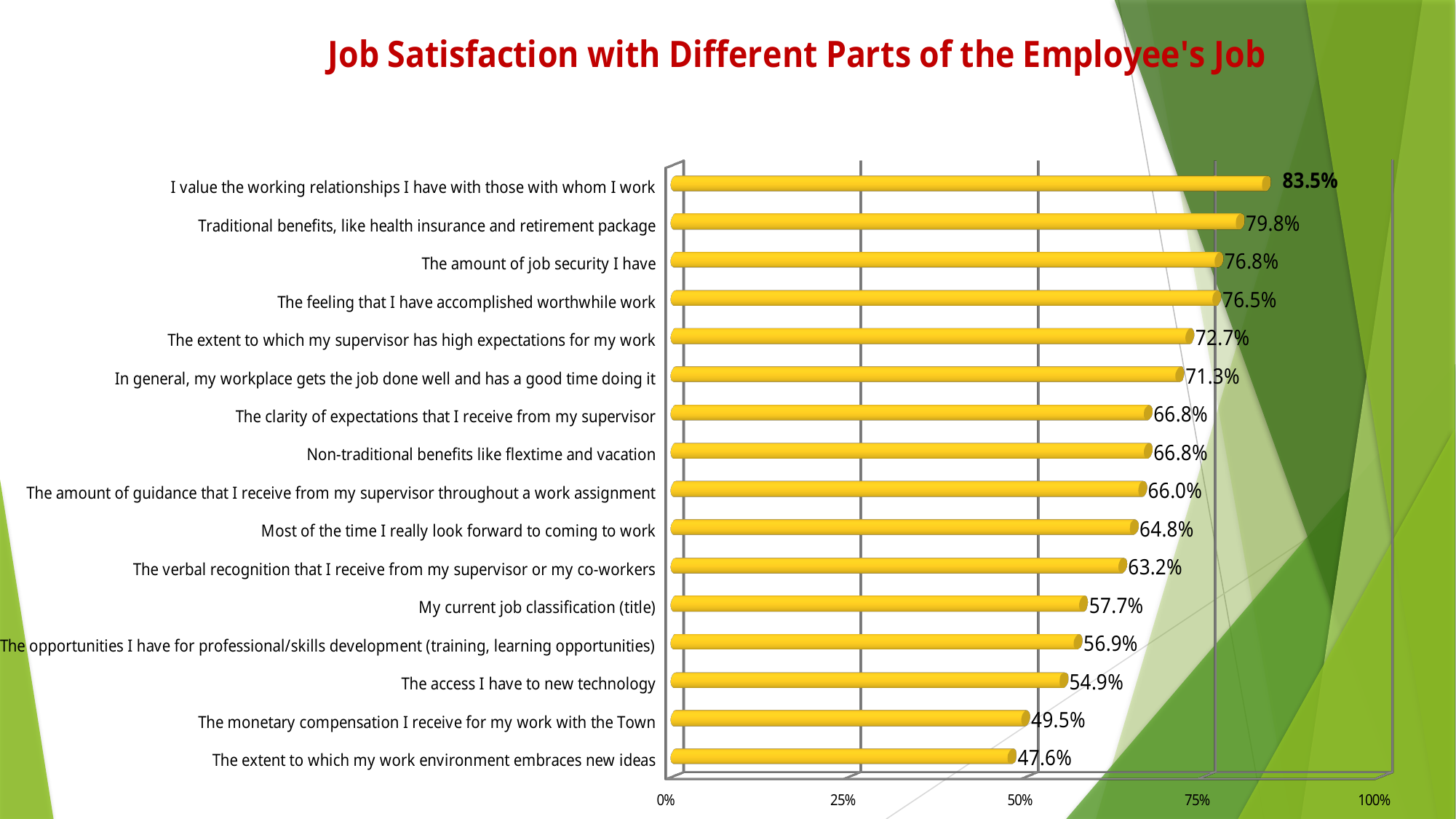
Is the value for "The extent to which my supervisor has high expectations for my work" greater or less than 75%? less Which is larger: the value for "My current job classification (title)" or the value for "The verbal recognition that I receive from my supervisor or my co-workers"? The verbal recognition that I receive from my supervisor or my co-workers What is the value for "The monetary compensation I receive for my work with the Town"? 49.5% What is the title of the chart? Job Satisfaction with Different Parts of the Employee's Job What kind of chart is shown on the slide? Bar chart What is the value for "Most of the time I really look forward to coming to work"? 64.8% Which category has the highest value? I value the working relationships I have with those with whom I work Which category has the lowest value? The extent to which my work environment embraces new ideas What is the difference between the values for "Traditional benefits, like health insurance and retirement package" and "The access I have to new technology"? 24.9% What is the value for "The amount of job security I have"? 76.8% How many categories are shown in the chart? 16 What colour are the bars in the chart? Yellow